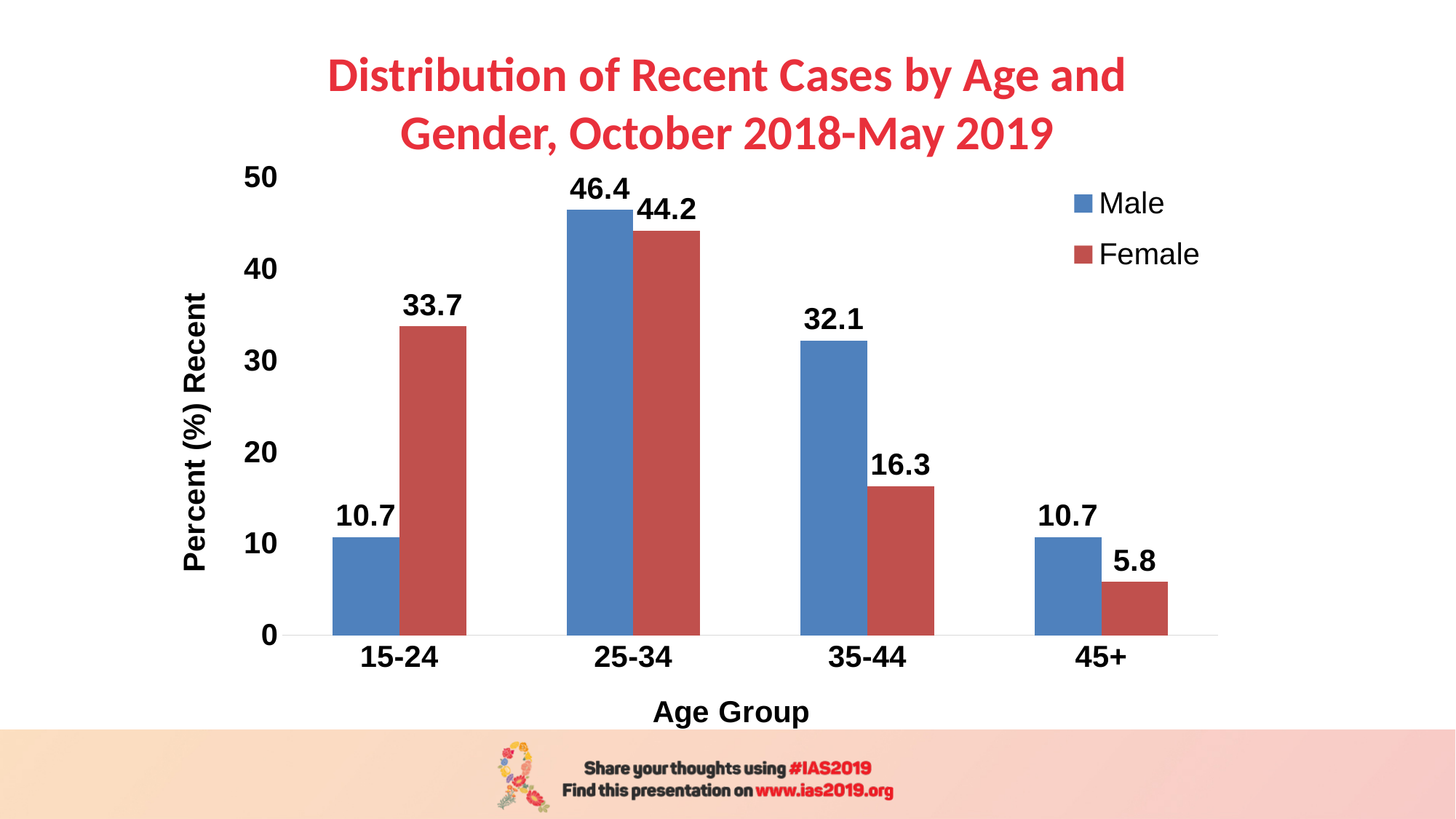
Which age group has the highest Female value? 25-34 Is the Male value for the 35-44 age group greater or less than 30? greater Which age group has the lowest Female value? 45+ How many age groups are shown on the x axis? 4 What is the difference between the Male and Female values for the 35-44 age group? 15.8 What is the Female value for the 15-24 age group? 33.7 What kind of chart is shown on the slide? Bar chart What is the Female value for the 45+ age group? 5.8 What is the Male value for the 25-34 age group? 46.4 What is the label of the y axis? Percent (%) Recent Which is larger for the 15-24 age group, the Male value or the Female value? Female How many series does the legend list? 2